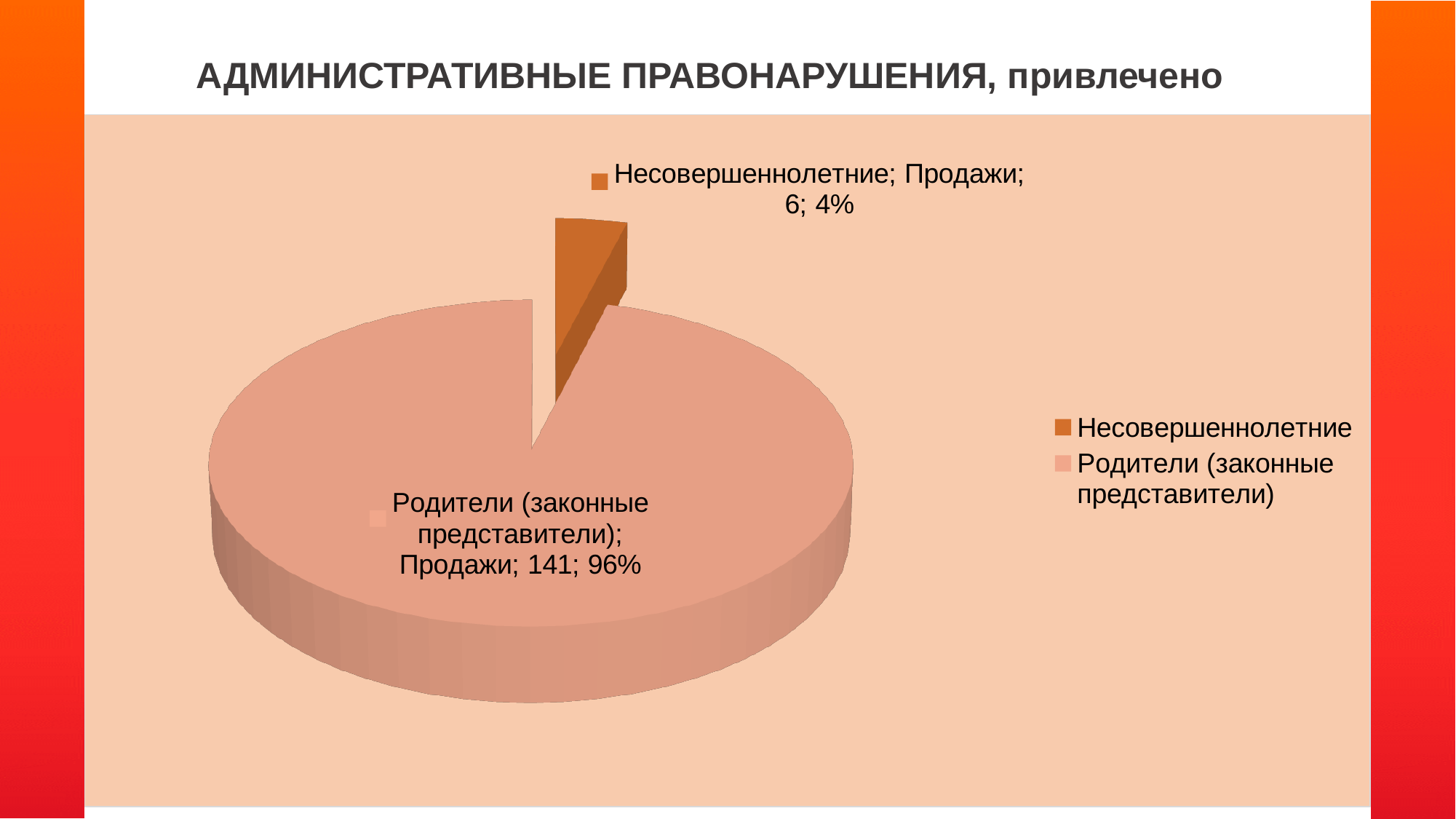
Which category has the smallest slice? Несовершеннолетние Which category has the largest slice? Родители (законные представители) What is the value for Родители (законные представители)? 141 What is the title of the slide? АДМИНИСТРАТИВНЫЕ ПРАВОНАРУШЕНИЯ, привлечено What is the value for Несовершеннолетние? 6 Which is larger, the value for Несовершеннолетние or the value for Родители (законные представители)? Родители (законные представители) What share of the pie does the Родители (законные представители) slice represent? 96% What is the difference between the values for Родители (законные представители) and Несовершеннолетние? 135 What share of the pie does the Несовершеннолетние slice represent? 4% What is the total of the two values shown in the pie chart? 147 What kind of chart is shown on the slide? Pie chart How many categories does the pie chart have? 2